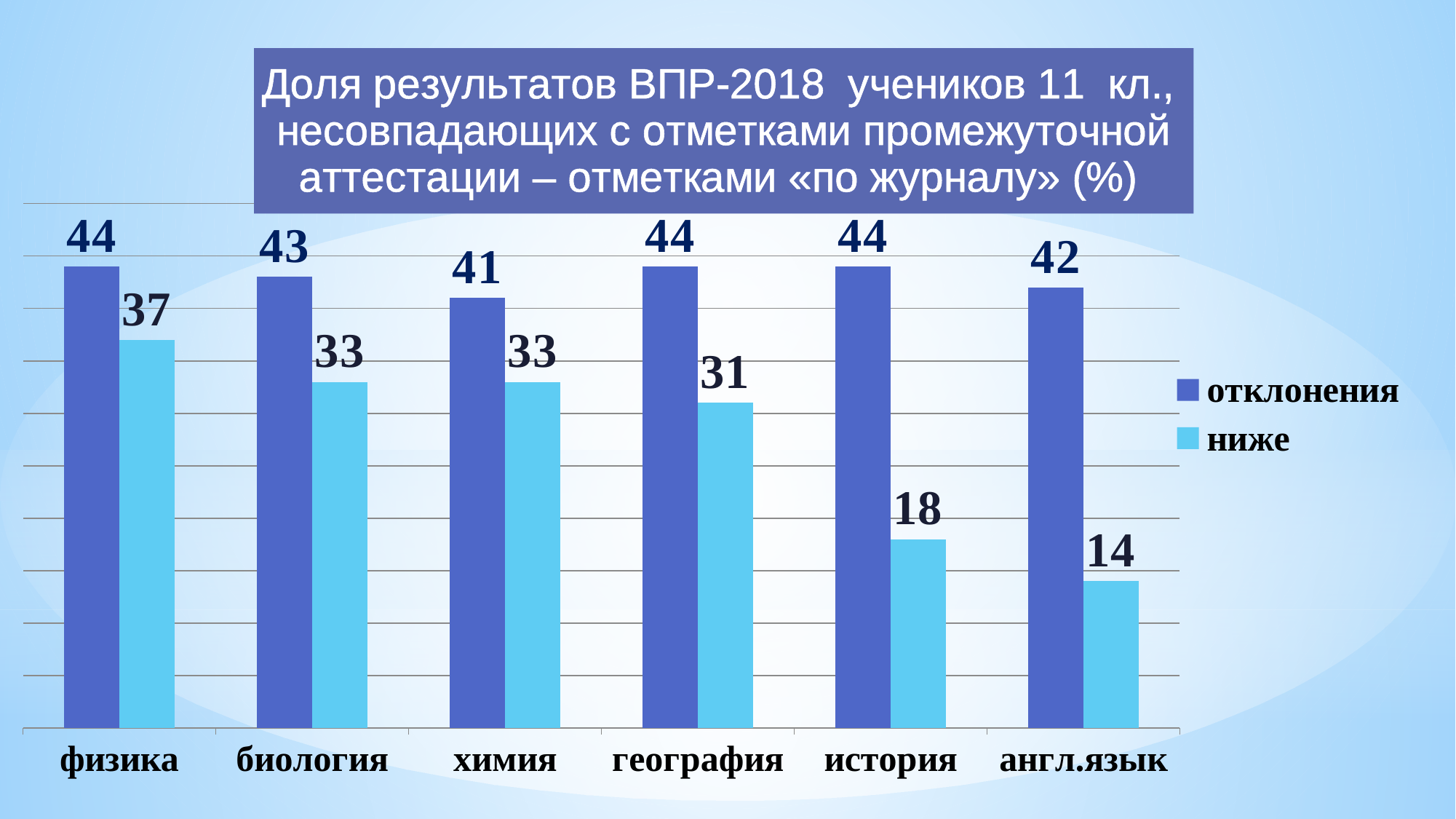
What is the value of «отклонения» for физика? 44 How many series does the legend list? 2 What is the difference between «отклонения» and «ниже» for география? 13 How many subjects are shown on the x axis? 6 Which is larger for биология: «отклонения» or «ниже»? отклонения Which subject has the lowest value for «отклонения»? химия What is the value of «отклонения» for химия? 41 Which subject has the highest value for «ниже»? физика What is the value of «ниже» for история? 18 What is the value of «ниже» for англ.язык? 14 What kind of chart is shown on the slide? bar chart Which subject has the lowest value for «ниже»? англ.язык